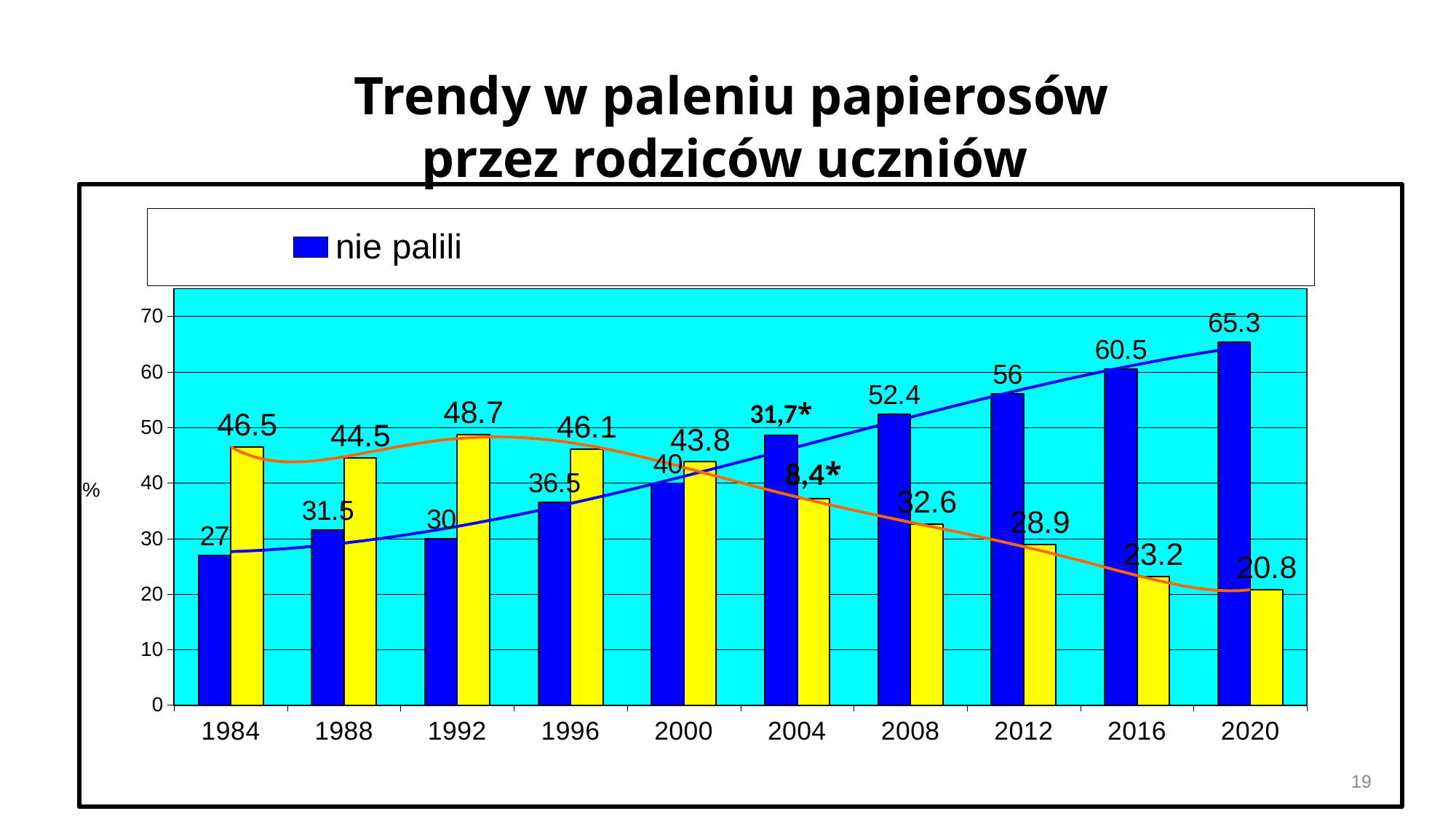
Is the 'nie palili' value for 2012 greater or less than 50? greater What is the value of the yellow bar for 2020? 20.8 What is the value of the yellow bar for 1992? 48.7 In which year is the 'nie palili' bar lowest? 1984 What is the value of the 'nie palili' bar for 1984? 27 In which year is the 'nie palili' bar highest? 2020 Do the 'nie palili' values rise or fall from 1984 to 2020? rise What is the difference between the 'nie palili' values for 2020 and 2016? 4.8 In 1996, which bar is larger, the blue 'nie palili' bar or the yellow bar? the yellow bar How many years are shown on the x axis? 10 What is the value of the 'nie palili' bar for 2020? 65.3 What kind of chart is shown on the slide? bar chart